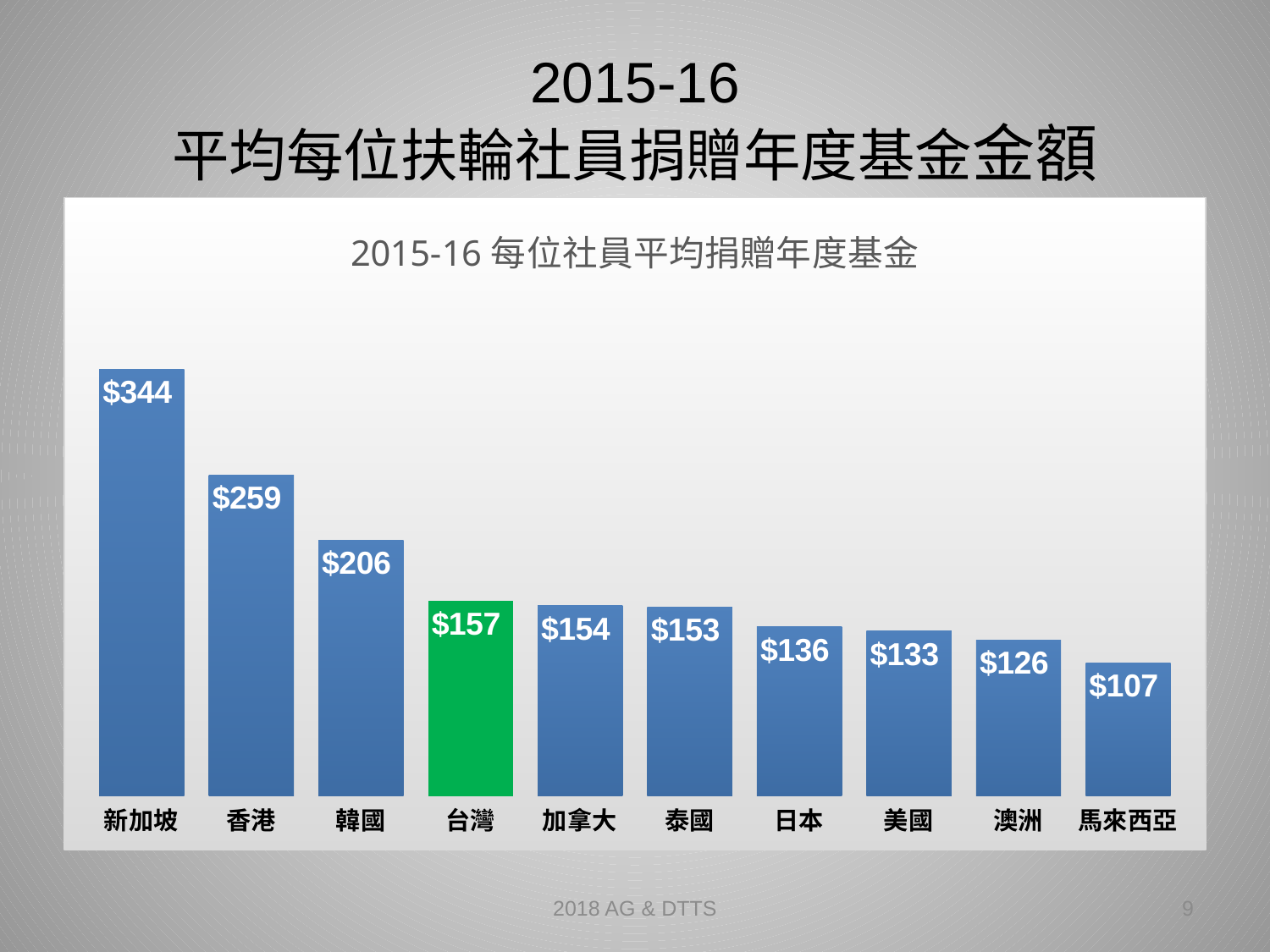
Which category has the highest value? 新加坡 Which is larger, the value for 香港 or the value for 美國? 香港 What is the difference between the values for 韓國 and 台灣? $49 Do the values rise or fall from left to right along the x axis? fall What is the value for 日本? $136 What is the value for 新加坡? $344 How many categories are shown in the chart? 10 Which category has the lowest value? 馬來西亞 What is the value for 台灣? $157 What is the difference between the values for 新加坡 and 香港? $85 What kind of chart is shown on the slide? bar chart Which category's bar is coloured green instead of blue? 台灣